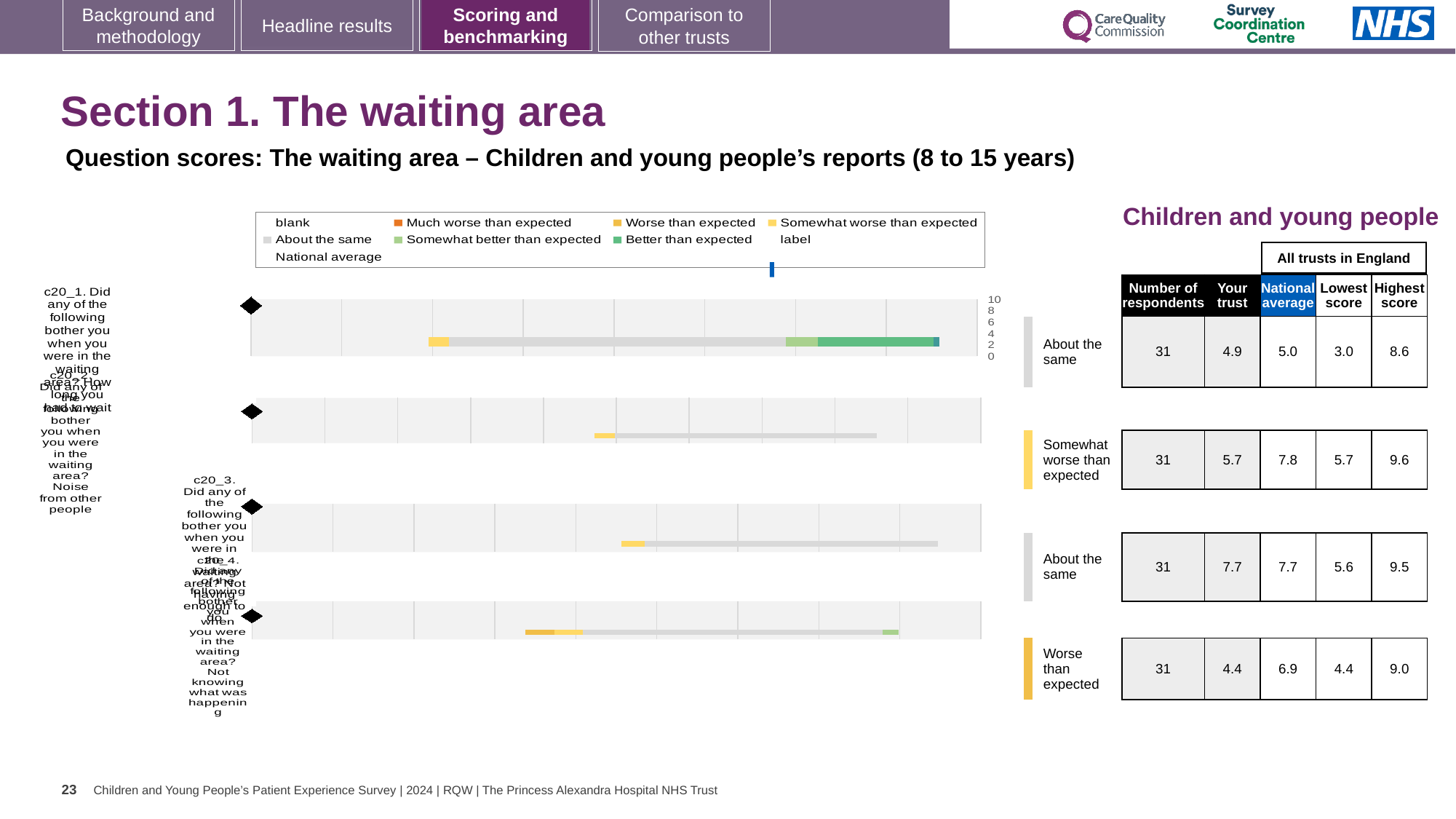
In the table beside the chart, which row has the lowest 'Your trust' score? Worse than expected (fourth row), 4.4 In the table beside the chart, what is the 'Your trust' score in the first row (About the same)? 4.9 In the table beside the chart, how many respondents are listed for each question? 31 What colour does the legend use for 'Better than expected'? green In the table beside the chart, which row has the highest 'Your trust' score? About the same (third row), 7.7 In the table beside the chart, what is the difference between the national average and the 'Your trust' score in the second row (Somewhat worse than expected)? 2.1 How many question bars (c20_1 to c20_4) are plotted in the chart? 4 In the table beside the chart, what is the national average in the second row (Somewhat worse than expected)? 7.8 What colour does the legend use for 'Much worse than expected'? orange In the table beside the chart, is the 'Your trust' score or the national average larger in the fourth row (Worse than expected)? National average How many entries does the chart legend list? 9 What kind of chart is used to show the question scores for the waiting area? bar chart